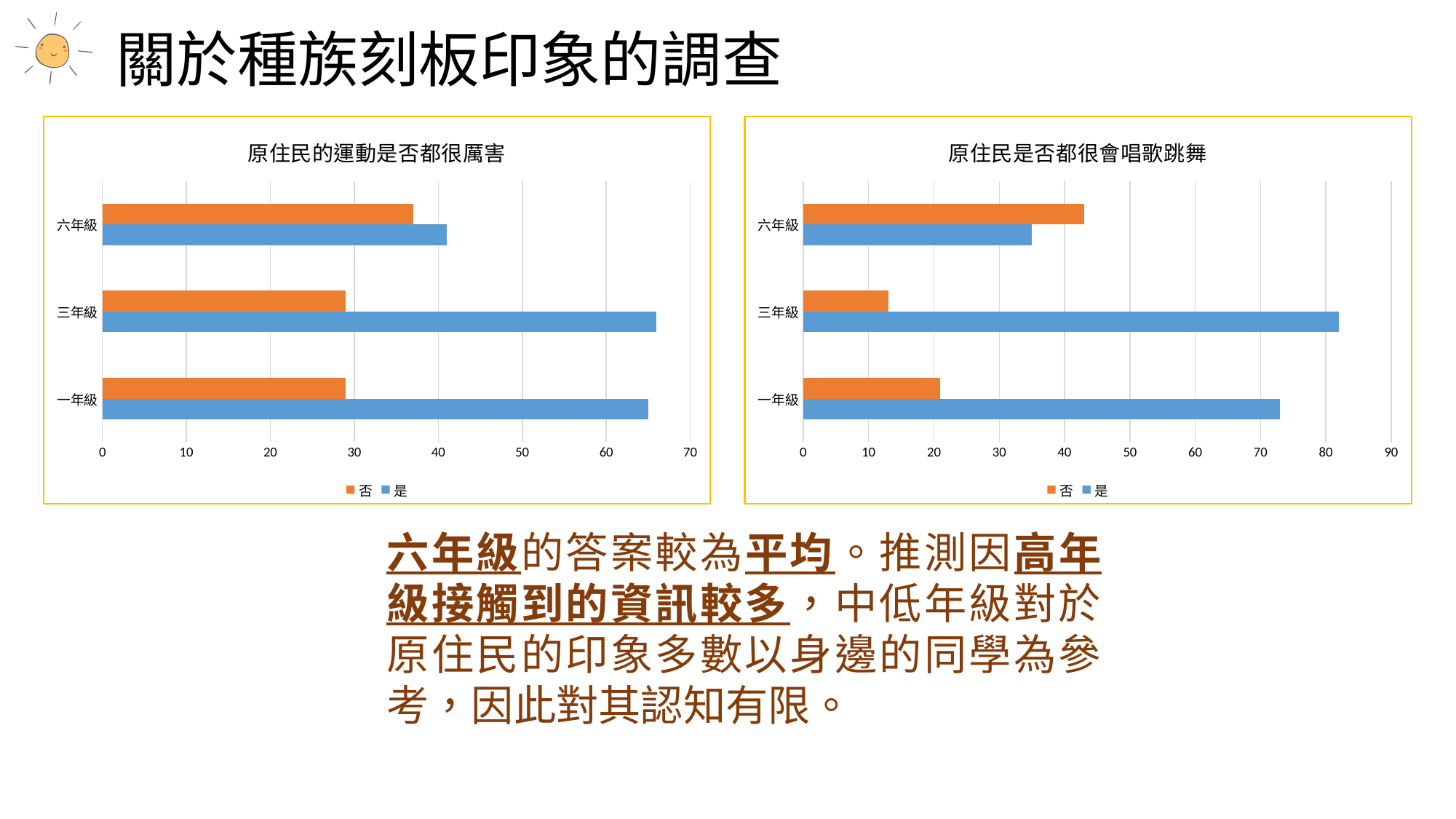
In the chart titled 原住民的運動是否都很厲害, is the 否 value for 六年級 greater or less than 30? greater In the chart titled 原住民是否都很會唱歌跳舞, is the 是 value for 三年級 greater or less than 80? greater In the chart titled 原住民是否都很會唱歌跳舞, is the 否 value for 三年級 greater or less than 20? less In the chart titled 原住民是否都很會唱歌跳舞, which grade has the lowest 否 value? 三年級 How many grade categories are shown in the chart titled 原住民的運動是否都很厲害? 3 What type of chart is the chart titled 原住民的運動是否都很厲害? bar chart In the chart titled 原住民的運動是否都很厲害, which grade has the lowest 是 value? 六年級 How many series does the legend of the chart titled 原住民是否都很會唱歌跳舞 list? 2 In the chart titled 原住民是否都很會唱歌跳舞, which grade has the highest 是 value? 三年級 In the chart titled 原住民的運動是否都很厲害, which grade has the highest 否 value? 六年級 In the chart titled 原住民是否都很會唱歌跳舞, which is larger for 六年級, the 否 value or the 是 value? 否